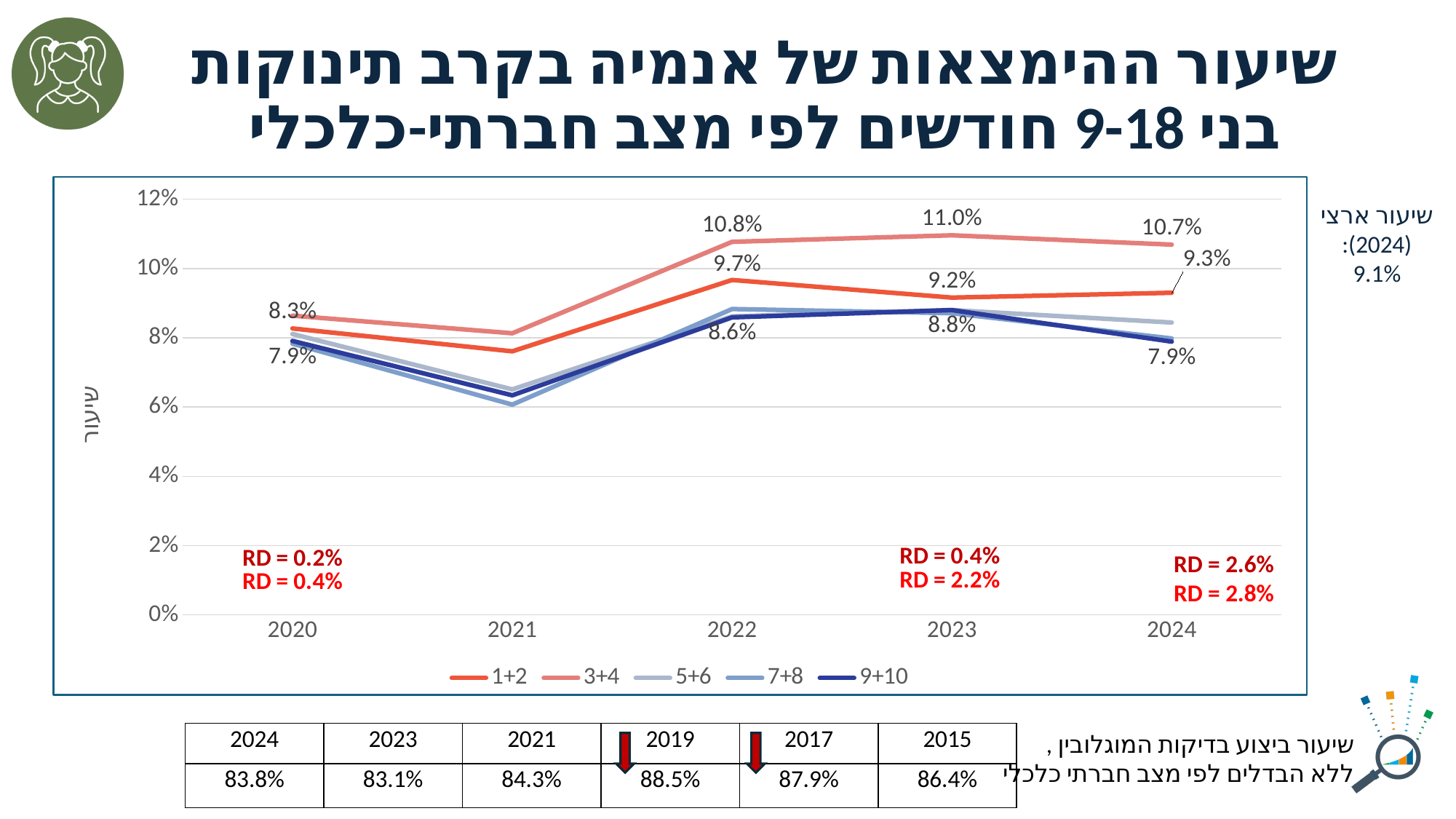
Which series has the larger value in 2022, 3+4 or 1+2? 3+4 How many series does the chart legend list? 5 What is the value for the 1+2 series in 2024? 9.3% What is the difference between the 3+4 and 1+2 series in 2023? 1.8 percentage points What is the value for the 3+4 series in 2022? 10.8% Is the value for the 9+10 series in 2021 greater or less than 8%? less What kind of chart is shown on the slide? line chart What is the difference between the 3+4 and 1+2 series in 2024? 1.4 percentage points Is the value for the 3+4 series in 2021 greater or less than 10%? less What is the value for the 3+4 series in 2023? 11.0% In which year does the 3+4 series reach its highest value? 2023 How many years are shown on the x axis of the chart? 5